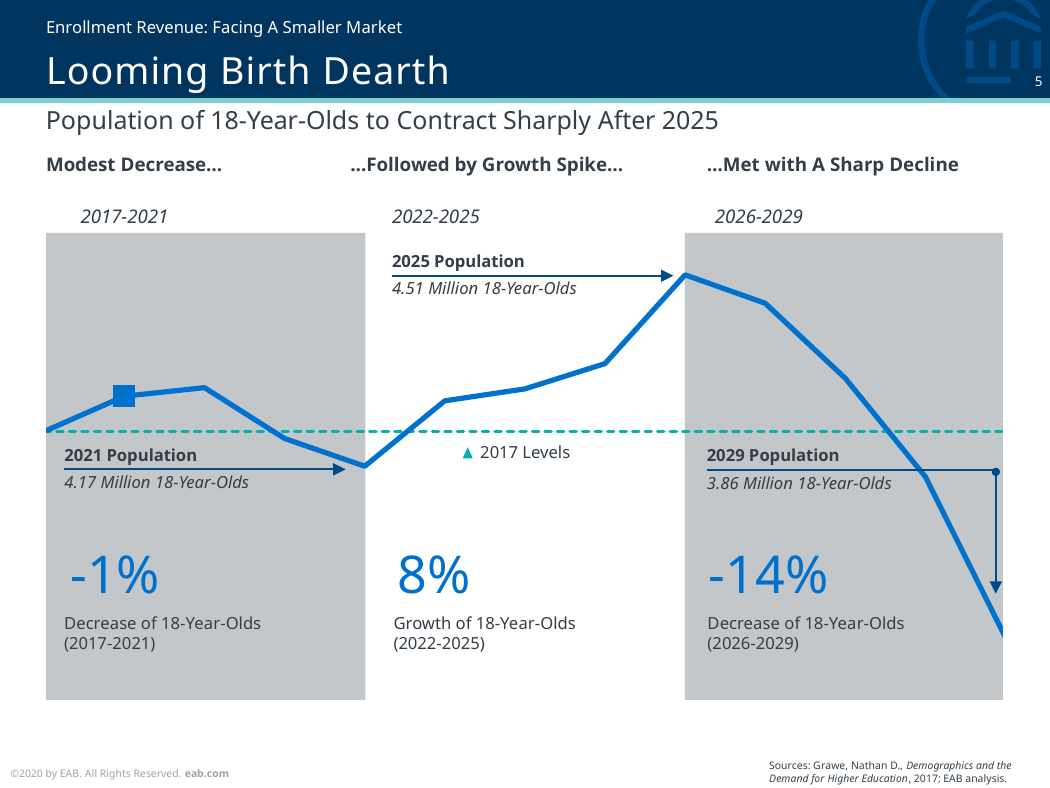
What kind of chart is used to show the population of 18-year-olds on this slide? line chart Which of the three labeled years (2021, 2025, 2029) has the highest population of 18-year-olds? 2025 What percentage growth in 18-year-olds is shown for 2022-2025? 8% Is the 2025 population of 18-year-olds larger or smaller than the 2029 population? larger Which of the three labeled years (2021, 2025, 2029) has the lowest population of 18-year-olds? 2029 What percentage change in 18-year-olds is shown for 2017-2021? -1% Does the line rise or fall between 2026 and 2029? fall How many time periods does the chart divide the years into? 3 What is the 2025 population of 18-year-olds shown on the chart? 4.51 Million What is the 2021 population of 18-year-olds shown on the chart? 4.17 Million What is the 2029 population of 18-year-olds shown on the chart? 3.86 Million What percentage decrease in 18-year-olds is shown for 2026-2029? -14%